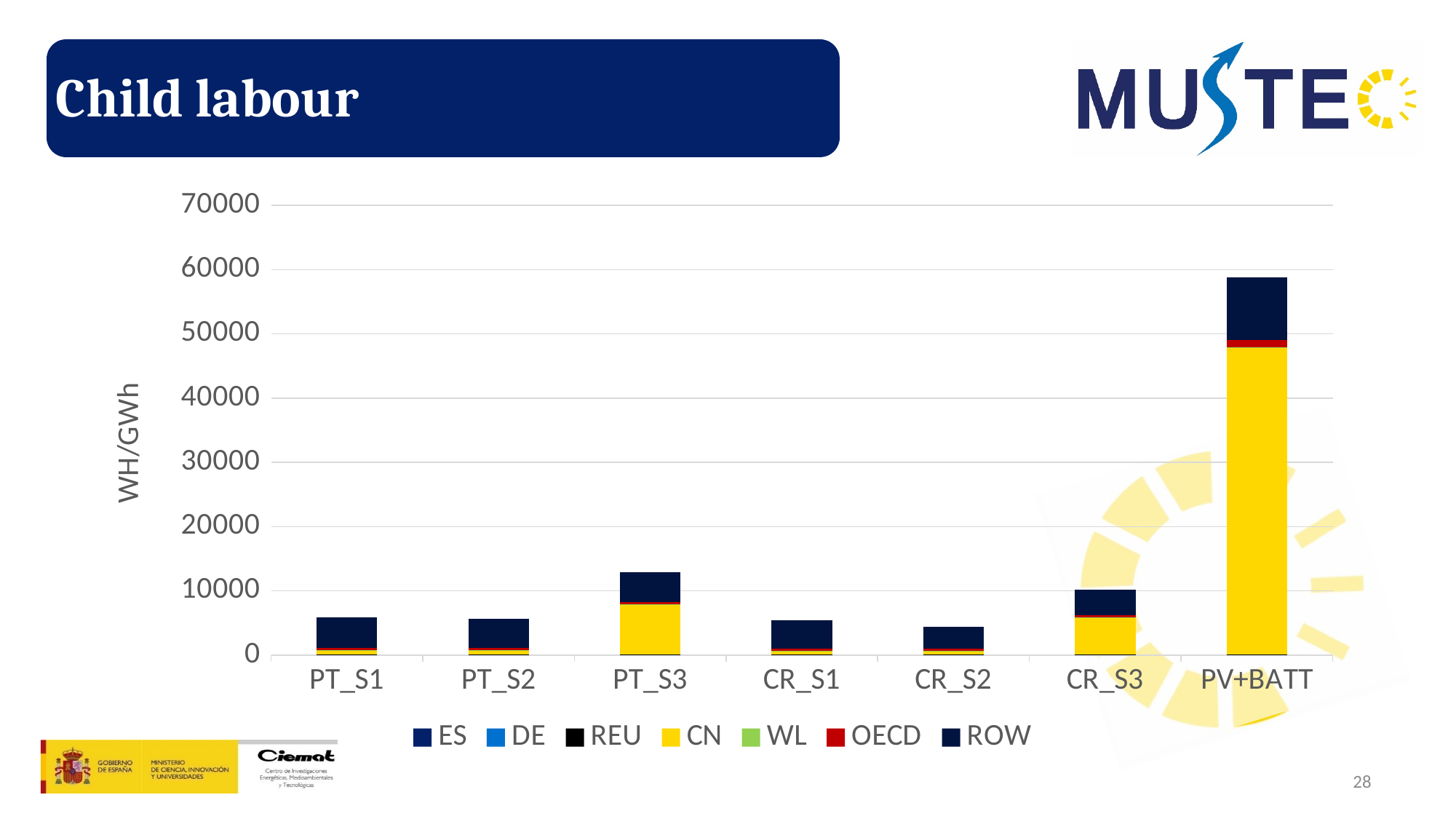
Which category has the lowest total bar in the chart? CR_S2 Is the total value for PV+BATT greater or less than 50000? greater Which series in the legend is shown in yellow? CN What is the label on the y axis of the chart? WH/GWh How many series does the chart's legend list? 7 Is the total value for CR_S3 greater or less than 20000? less How many categories are shown on the x axis of the chart? 7 Is the total value for PT_S1 greater or less than 10000? less Which category has the highest total bar in the chart? PV+BATT Which has the larger total bar, PT_S3 or CR_S3? PT_S3 What kind of chart is shown on the slide? Stacked bar chart